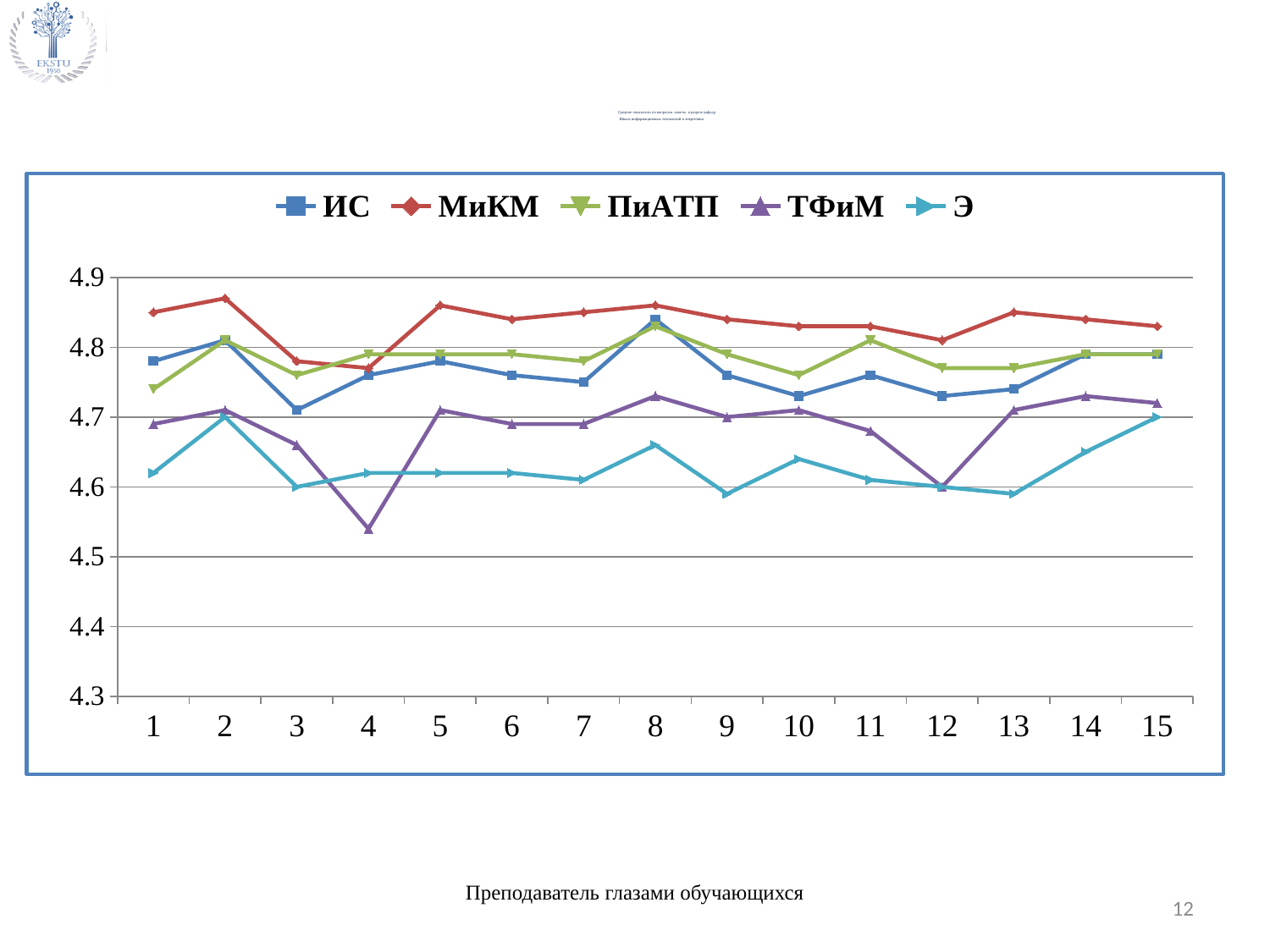
How many points are plotted along the x axis for each series? 15 Is the value for МиКМ at point 2 greater or less than 4.8? greater At point 1, which series has the larger value, МиКМ or ИС? МиКМ Is the value for ПиАТП at point 1 greater or less than 4.8? less What colour is the line for the МиКМ series? red Between points 13 and 15, does the Э series rise or fall? rise What kind of chart is shown on the slide? line chart Is the value for Э at point 8 greater or less than 4.6? greater How many series does the legend list? 5 Which series has the lowest point anywhere on the chart? ТФиМ At point 4, which series has the larger value, ТФиМ or Э? Э